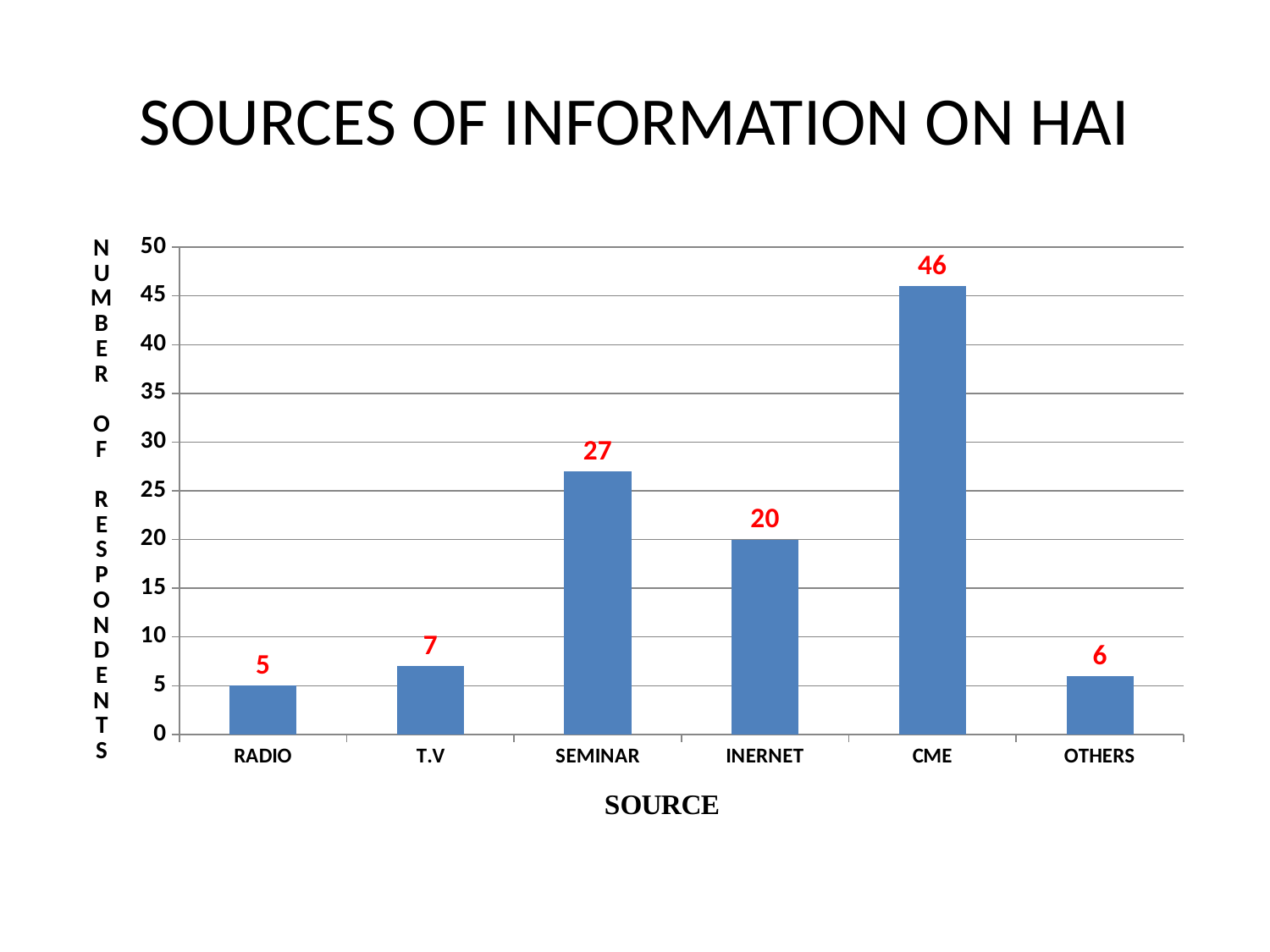
What is the title of the slide? SOURCES OF INFORMATION ON HAI What is the number of respondents for SEMINAR? 27 What kind of chart is shown on the slide? Bar chart What is the number of respondents for INERNET? 20 What is the difference in number of respondents between CME and SEMINAR? 19 Which has more respondents, SEMINAR or INERNET? SEMINAR What is the number of respondents for RADIO? 5 Which source has the highest number of respondents? CME What is the difference in number of respondents between T.V and OTHERS? 1 Which source has the lowest number of respondents? RADIO How many sources are shown on the x axis? 6 What is the number of respondents for CME? 46